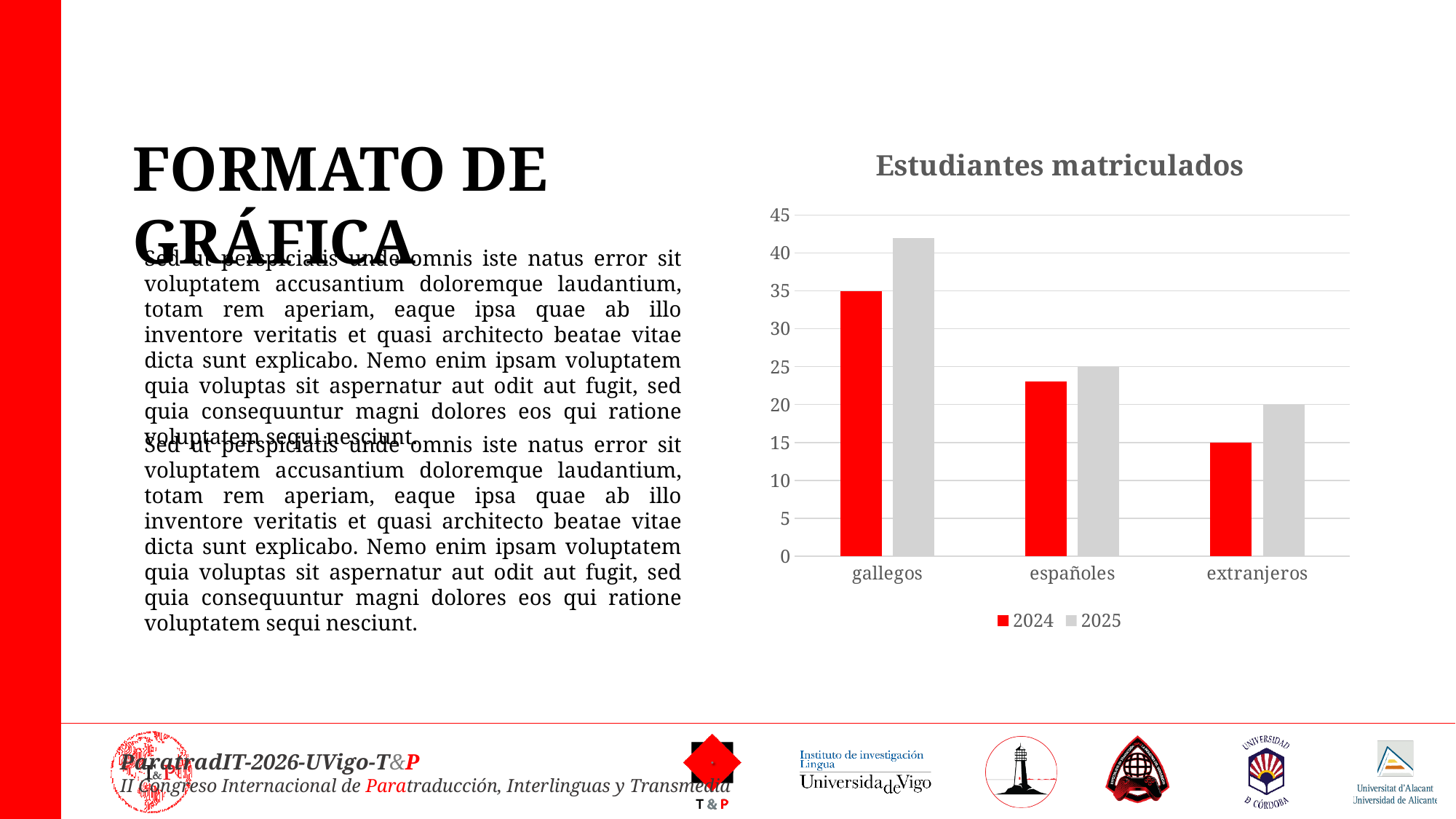
What is the title of the chart? Estudiantes matriculados How many series does the legend list? 2 What is the difference between the 2025 and 2024 values for extranjeros? 5 Is the value for españoles in 2024 greater or less than 25? less Is the value for gallegos in 2025 greater or less than 40? greater What is the value for gallegos in 2024? 35 Which category has the highest value in the 2025 series? gallegos How many categories are shown on the x axis? 3 What is the value for extranjeros in 2024? 15 What is the value for extranjeros in 2025? 20 What type of chart is shown on the slide? bar chart What is the value for españoles in 2025? 25